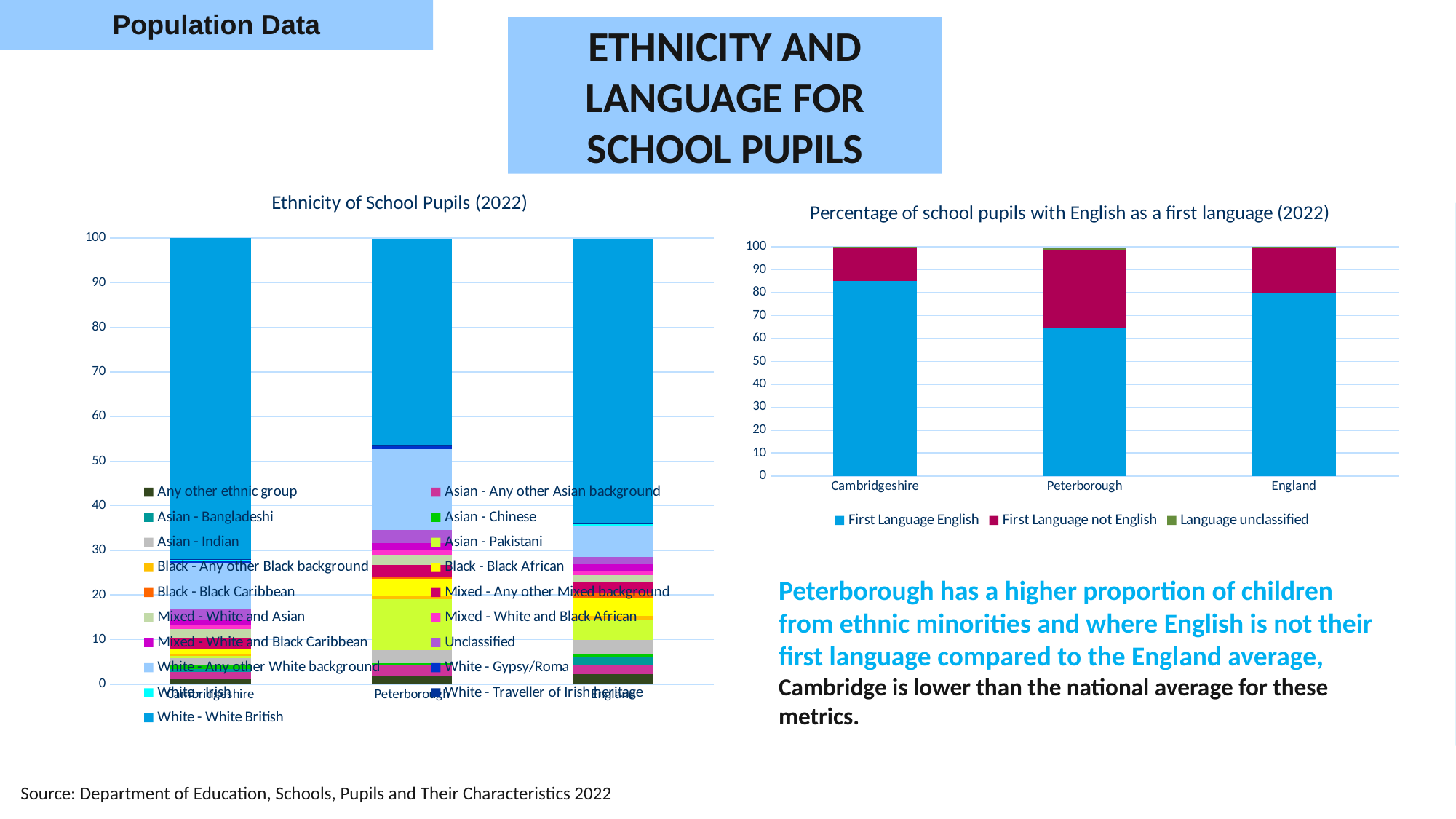
In the 'Ethnicity of School Pupils (2022)' chart, which category has the smallest White - White British segment? Peterborough What type of chart is the 'Percentage of school pupils with English as a first language (2022)' chart? Stacked bar chart In the 'Percentage of school pupils with English as a first language (2022)' chart, which category has the highest value for First Language English? Cambridgeshire In the 'Percentage of school pupils with English as a first language (2022)' chart, which category has the lowest value for First Language English? Peterborough How many categories are shown on the x axis of the 'Ethnicity of School Pupils (2022)' chart? 3 How many series does the legend list in the 'Percentage of school pupils with English as a first language (2022)' chart? 3 What is the title of the chart on the left of the slide? Ethnicity of School Pupils (2022) In the 'Percentage of school pupils with English as a first language (2022)' chart, is the First Language English value for Cambridgeshire greater or less than 80? greater In the 'Ethnicity of School Pupils (2022)' chart, is the White - White British value for Peterborough greater or less than 50? less How many categories are shown on the x axis of the 'Percentage of school pupils with English as a first language (2022)' chart? 3 In the 'Percentage of school pupils with English as a first language (2022)' chart, is the First Language English value for Peterborough greater or less than 70? less In the 'Percentage of school pupils with English as a first language (2022)' chart, which is larger: the First Language not English segment for Peterborough or for Cambridgeshire? Peterborough